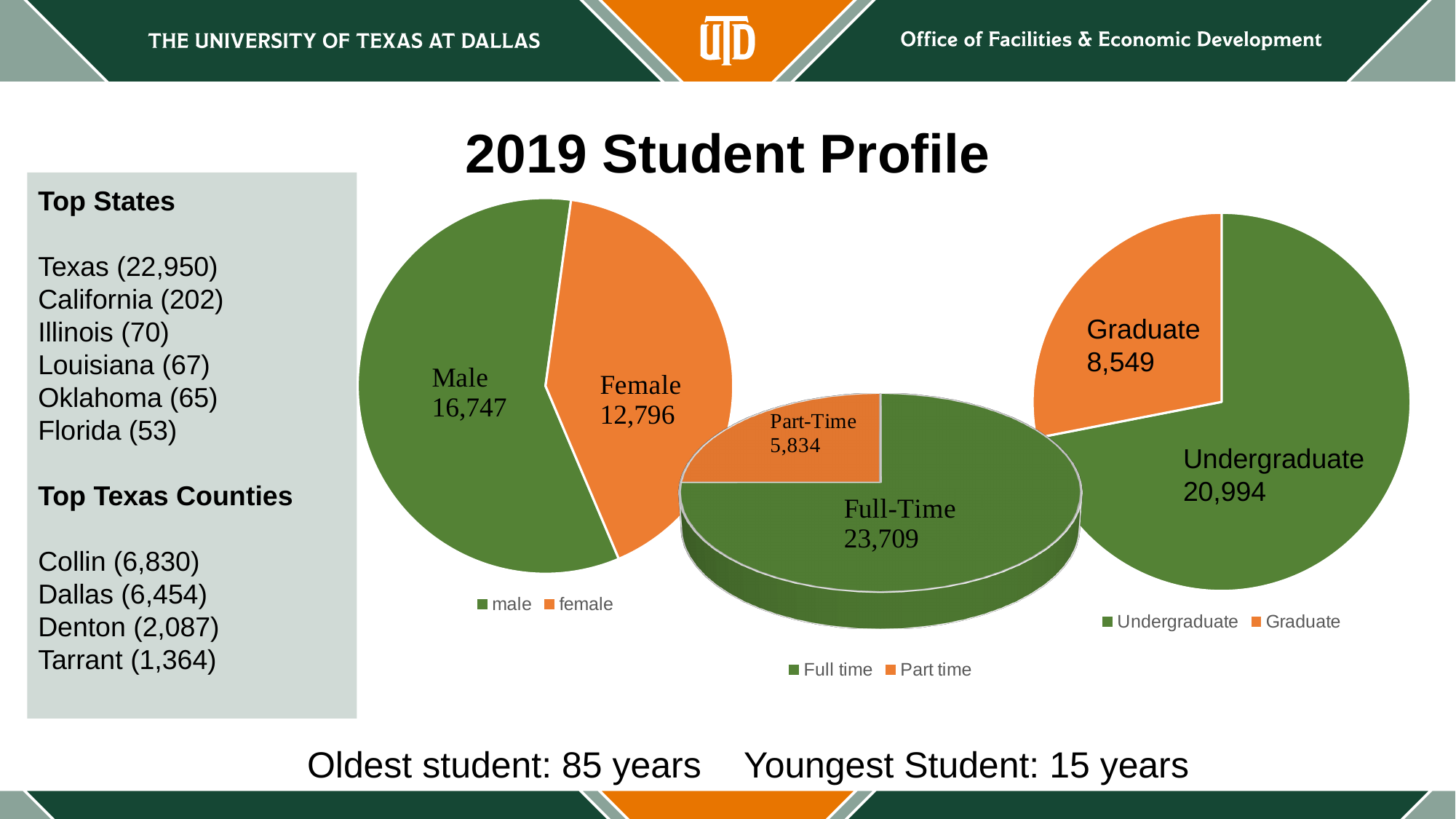
On the middle pie chart (full time/part time), what is the total of the two slices? 29,543 What type of chart is the left chart (male/female)? Pie chart On the middle pie chart (full time/part time), which category is the smallest? Part-Time On the right pie chart (undergraduate/graduate), what is the value for Graduate? 8,549 How many pie charts are shown on the slide? 3 On the left pie chart (male/female), what is the difference between the Male and Female values? 3,951 On the middle pie chart (full time/part time), what is the value for Part-Time? 5,834 On the right pie chart (undergraduate/graduate), what is the difference between the Undergraduate and Graduate values? 12,445 On the left pie chart (male/female), what is the value for Male? 16,747 On the left pie chart (male/female), what is the value for Female? 12,796 On the right pie chart (undergraduate/graduate), which category is the largest? Undergraduate On the middle pie chart (full time/part time), what is the value for Full-Time? 23,709